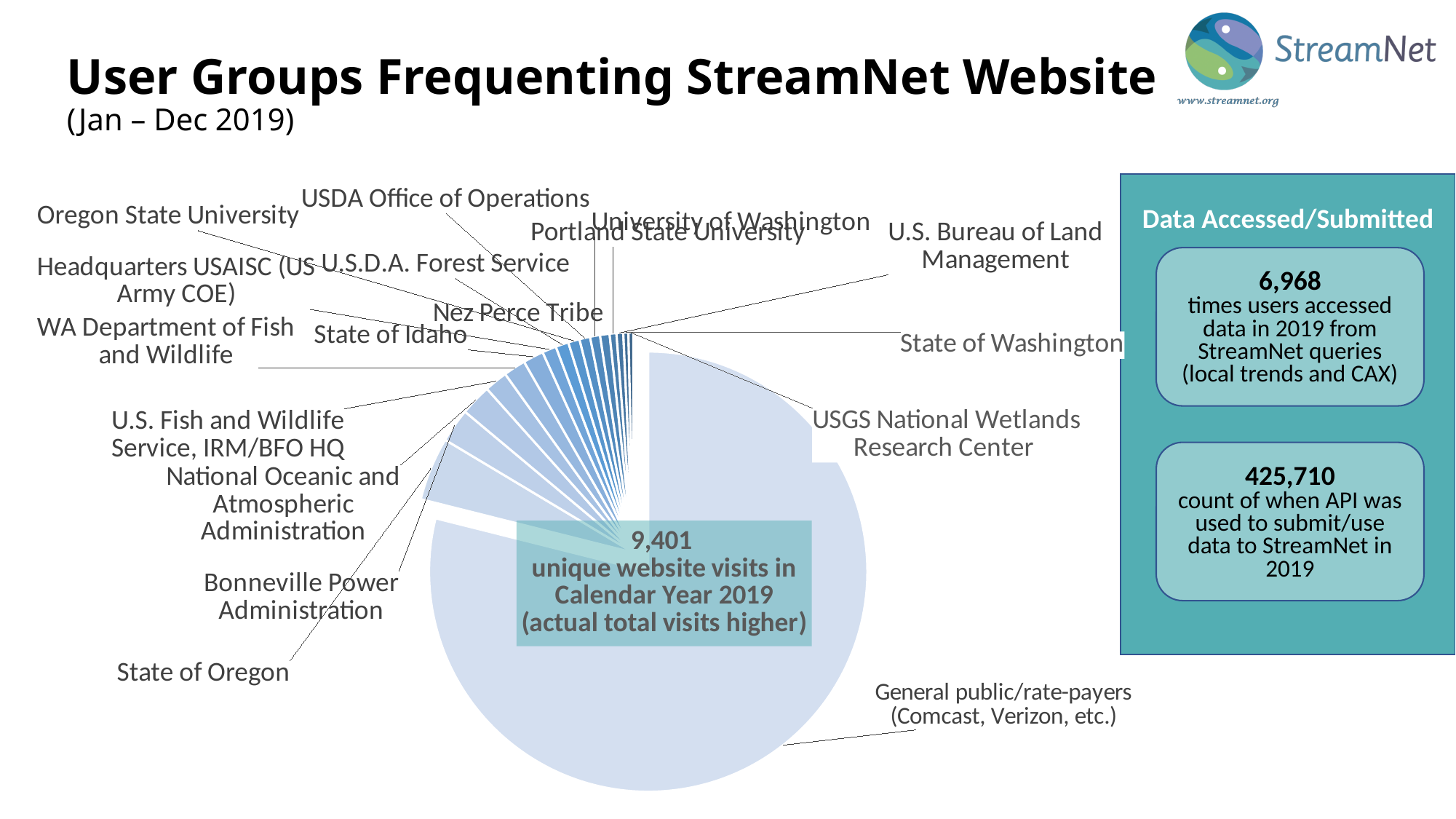
What is the title of the chart on the slide? User Groups Frequenting StreamNet Website According to the label in the centre of the pie chart, how many unique website visits were there in Calendar Year 2019? 9,401 Which slice is larger: State of Oregon or Oregon State University? State of Oregon Which user group has the largest slice of the pie chart? General public/rate-payers (Comcast, Verizon, etc.) Which slice is larger: General public/rate-payers or State of Oregon? General public/rate-payers What kind of chart is shown on the slide? pie chart Which slice is larger: General public/rate-payers or Bonneville Power Administration? General public/rate-payers